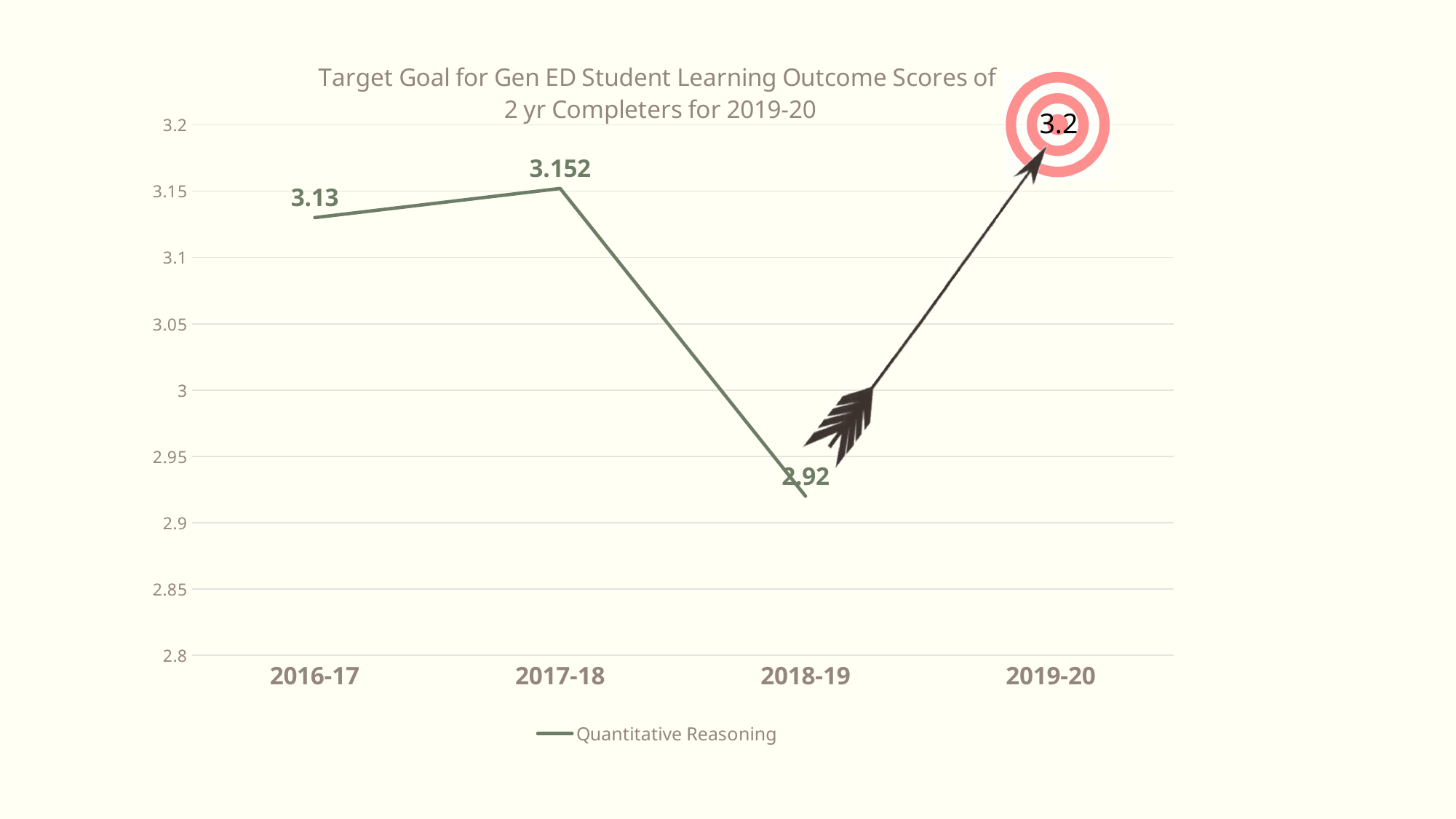
What is the Quantitative Reasoning score for 2018-19? 2.92 Which year has the highest plotted Quantitative Reasoning score? 2017-18 Is the score for 2018-19 greater or less than 3? less What series name does the legend list? Quantitative Reasoning What is the target goal score shown for 2019-20? 3.2 What is the Quantitative Reasoning score for 2017-18? 3.152 How many year categories are shown on the x axis? 4 What is the difference between the 2017-18 score and the 2018-19 score? 0.232 Which year has the lowest plotted Quantitative Reasoning score? 2018-19 What is the Quantitative Reasoning score for 2016-17? 3.13 Which is larger, the score for 2016-17 or the score for 2018-19? 2016-17 What kind of chart is shown on the slide? line chart